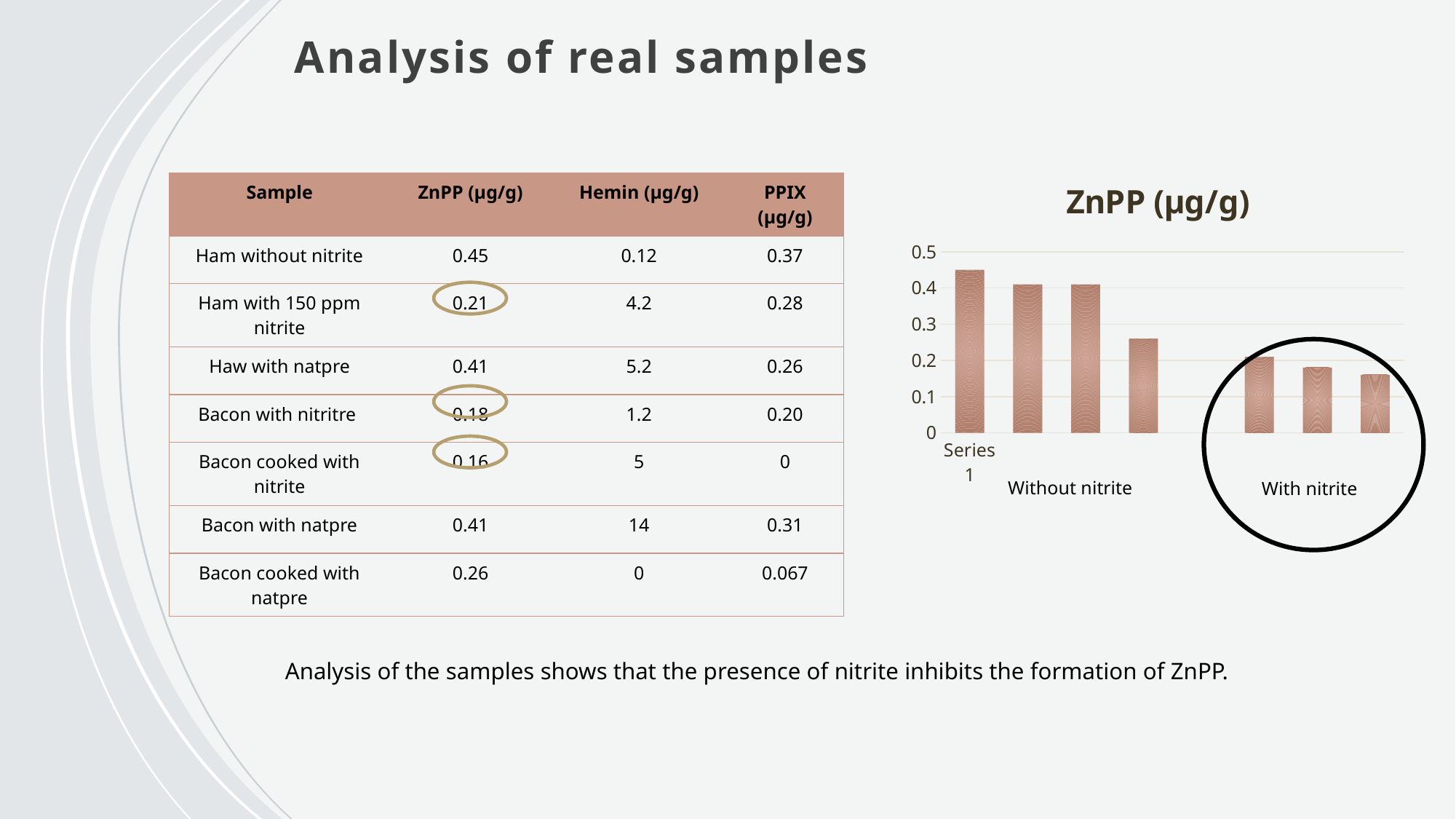
Is the value of the leftmost bar in the chart greater or less than 0.4? greater Which group of bars is circled in black on the chart? With nitrite Which is larger, the first bar or the last bar in the chart? the first bar What is the title of the chart? ZnPP (µg/g) What kind of chart is shown on the slide? bar chart Which bar in the chart is the shortest? the rightmost (last) bar Is the value of the fourth bar from the left greater or less than 0.3? less Which bar in the chart is the tallest? the leftmost (first) bar Which group of bars has lower values, 'Without nitrite' or 'With nitrite'? With nitrite How many bars are plotted in the ZnPP (µg/g) chart? 7 Do the bar values generally rise or fall from left to right across the chart? fall Is the value of the rightmost bar in the chart greater or less than 0.2? less